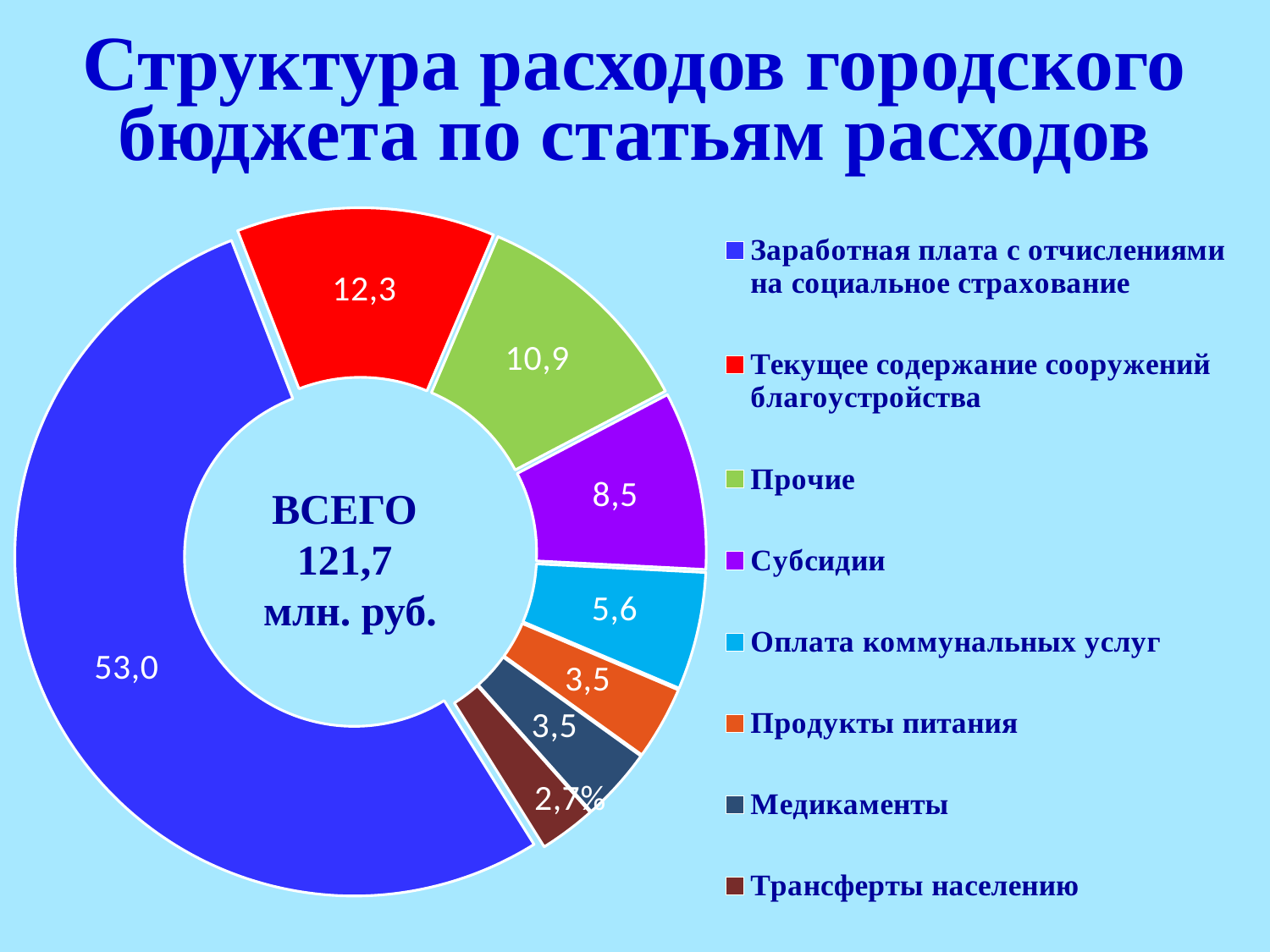
What is the difference between the values for 'Текущее содержание сооружений благоустройства' and 'Прочие'? 1,4 What value is shown for 'Субсидии'? 8,5 How many expense categories does the chart show? 8 What total amount is shown in the centre of the chart? 121,7 млн. руб. What value is shown for 'Прочие'? 10,9 Which is larger: the value for 'Субсидии' or for 'Оплата коммунальных услуг'? Субсидии What value is shown for 'Текущее содержание сооружений благоустройства'? 12,3 What kind of chart is shown on the slide? Doughnut (pie) chart What value is shown for 'Оплата коммунальных услуг'? 5,6 What value is shown for 'Заработная плата с отчислениями на социальное страхование'? 53,0 Which category has the smallest share of the chart? Трансферты населению Which category has the largest share of the chart? Заработная плата с отчислениями на социальное страхование